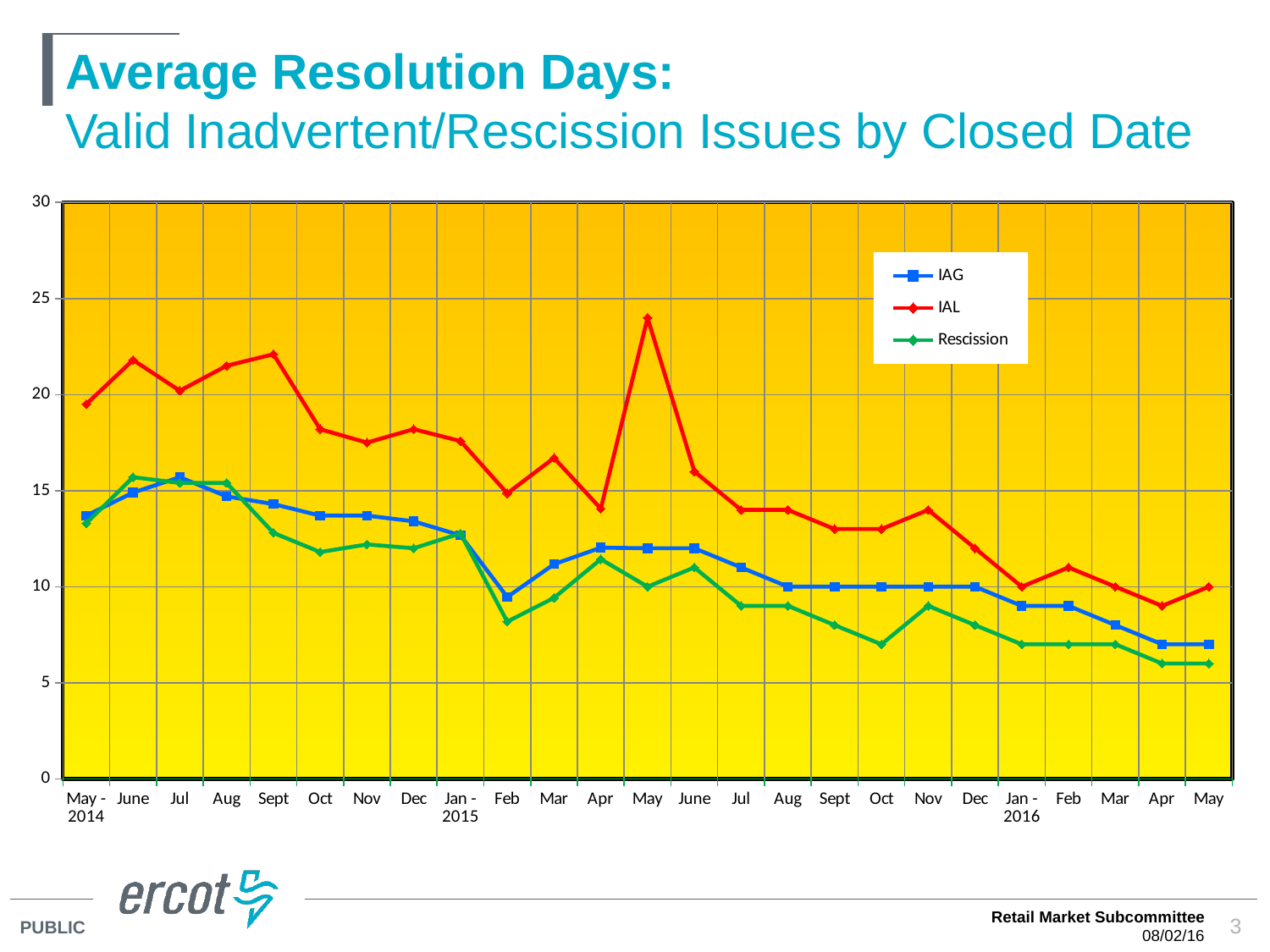
How many series does the legend list? 3 In which month does the IAL series reach its lowest value? Apr 2016 In which month does the IAL series reach its highest value? May 2015 Does the IAG series generally rise or fall from May 2014 to May 2016? fall Which series are listed in the legend? IAG, IAL, Rescission What kind of chart is shown on the slide? line chart Is the IAL value for May 2015 greater or less than 20? greater Is the Rescission value for Oct 2015 greater or less than 10? less In May 2015, which series has the larger value, IAL or IAG? IAL How many months are plotted along the x axis? 25 Is the IAL value for Sept 2014 greater or less than 20? greater